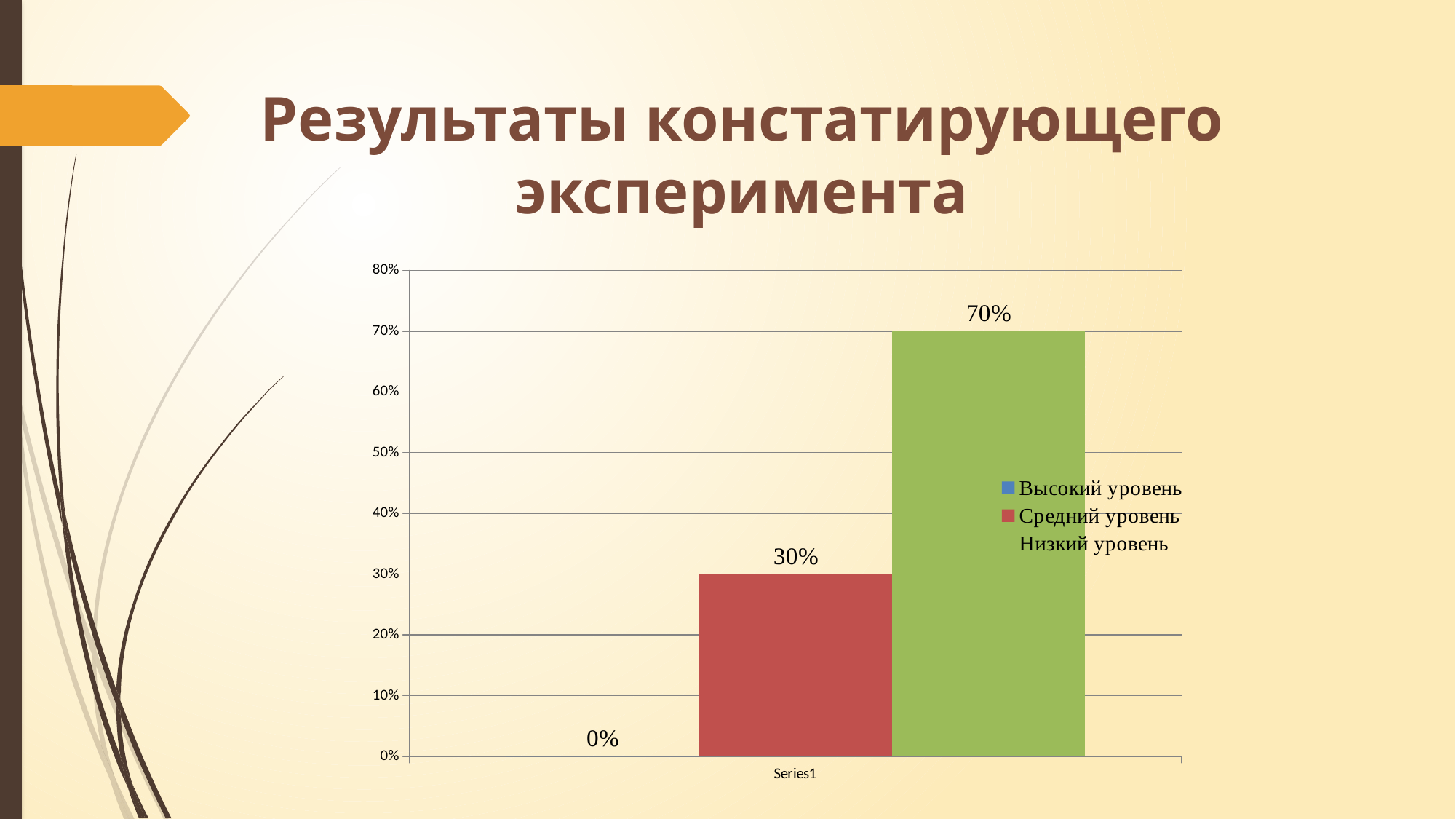
Which is larger, the value for Средний уровень or the value for Низкий уровень? Низкий уровень Is the value for Низкий уровень greater or less than 60%? greater What is the value for Высокий уровень? 0% What is the value for Низкий уровень? 70% What is the category label shown on the x axis? Series1 What is the value for Средний уровень? 30% What is the difference between the values for Низкий уровень and Средний уровень? 40% What kind of chart is shown on the slide? bar chart How many series does the legend list? 3 Which level has the lowest value? Высокий уровень Which level has the highest value? Низкий уровень What is the highest value shown on the y axis? 80%